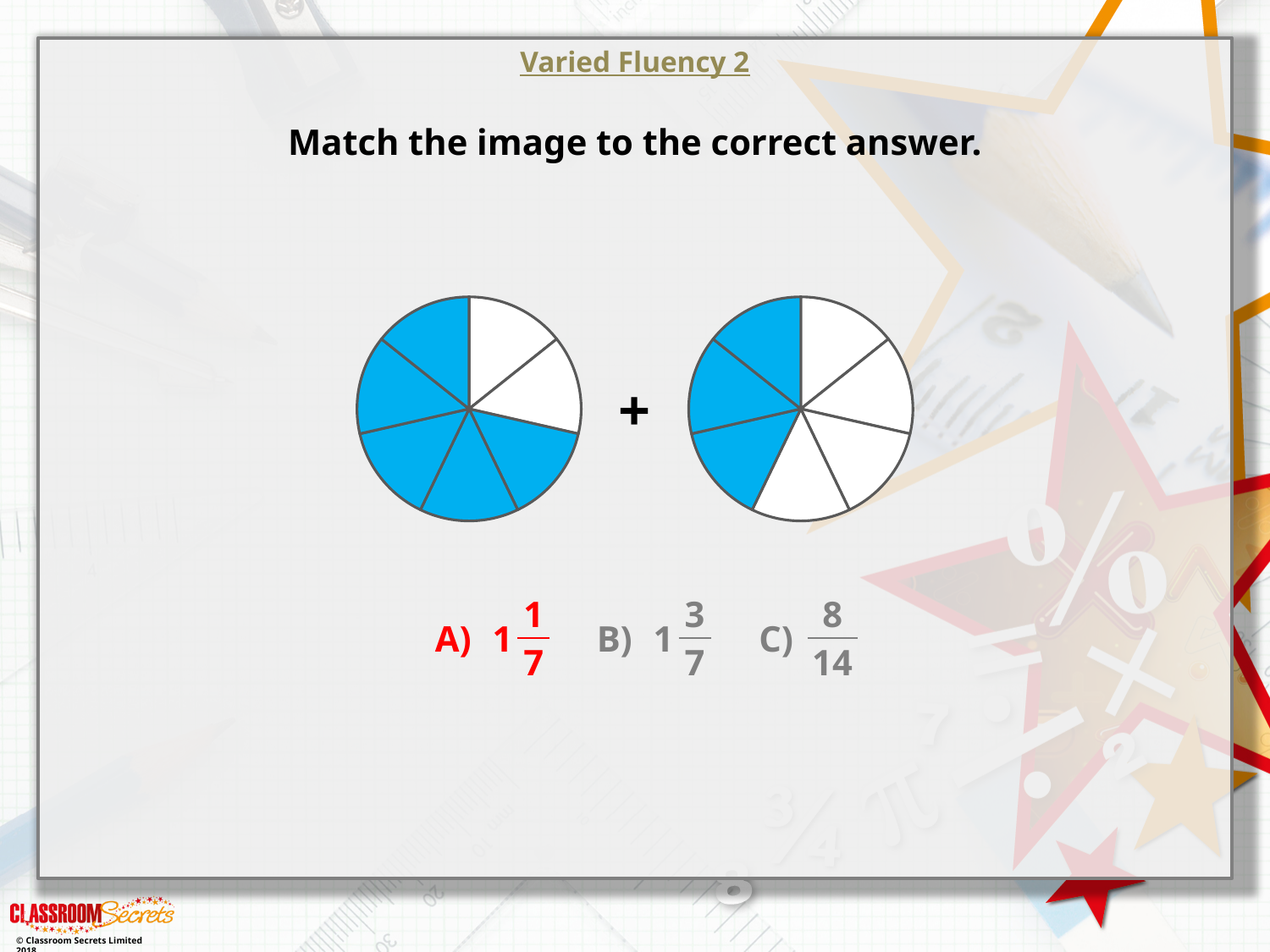
How many equal slices is the right circle divided into? 7 How many slices of the right circle are left white (unshaded)? 4 How many slices of the left circle are shaded blue? 5 Which circle has more blue shaded slices, the left or the right? left Which answer option is highlighted in red below the circles? A) 1 1/7 What colour are the shaded slices in both circles? blue What kind of chart is shown on the left of the plus sign? pie chart